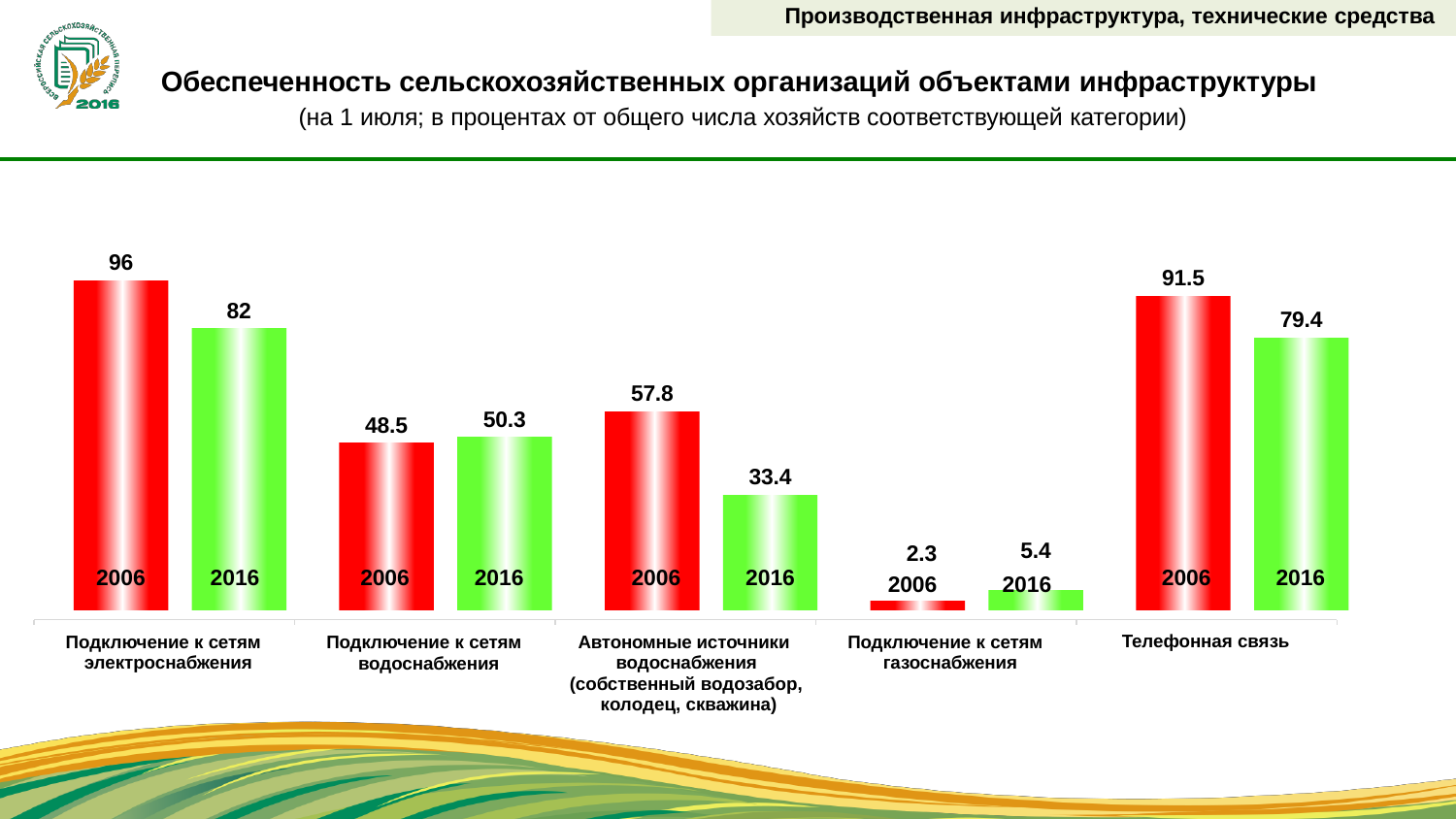
By how much did the value for «Автономные источники водоснабжения» change from 2006 to 2016? 24.4 What is the 2006 value for «Подключение к сетям электроснабжения»? 96 How many infrastructure categories are shown in the chart? 5 What type of chart is shown on the slide? bar chart For «Подключение к сетям водоснабжения», which year has the larger value, 2006 or 2016? 2016 What is the 2016 value for «Автономные источники водоснабжения»? 33.4 What is the 2006 value for «Подключение к сетям газоснабжения»? 2.3 Which category has the lowest 2016 value? Подключение к сетям газоснабжения Which category has the highest 2006 value? Подключение к сетям электроснабжения What is the difference between the 2006 and 2016 values for «Телефонная связь»? 12.1 What is the 2016 value for «Телефонная связь»? 79.4 Which two years are compared in the chart? 2006 and 2016